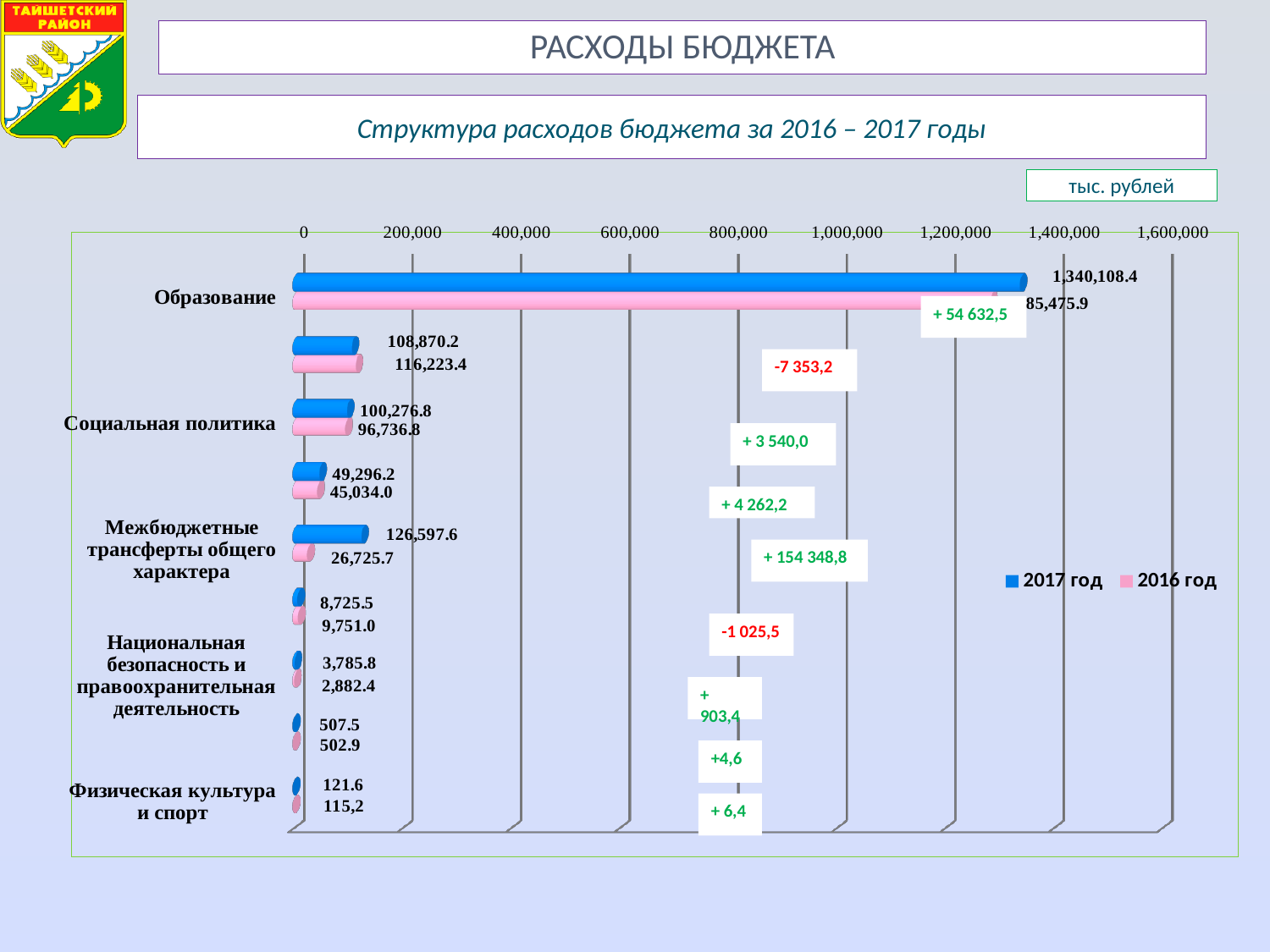
Is the 2017 год value for Образование greater or less than 1,200,000? greater What is the 2016 год value for Межбюджетные трансферты общего характера? 26,725.7 What is the 2017 год value for Социальная политика? 100,276.8 What is the 2017 год value for Межбюджетные трансферты общего характера? 126,597.6 What is the 2016 год value for Социальная политика? 96,736.8 Which category has the highest 2017 год value? Образование What is the 2016 год value for Физическая культура и спорт? 115,2 What is the 2017 год value for Образование? 1,340,108.4 How many series does the legend list? 2 What kind of chart is shown on the slide? bar chart For Социальная политика, which year has the larger value, 2017 год or 2016 год? 2017 год What is the 2017 год value for Национальная безопасность и правоохранительная деятельность? 3,785.8